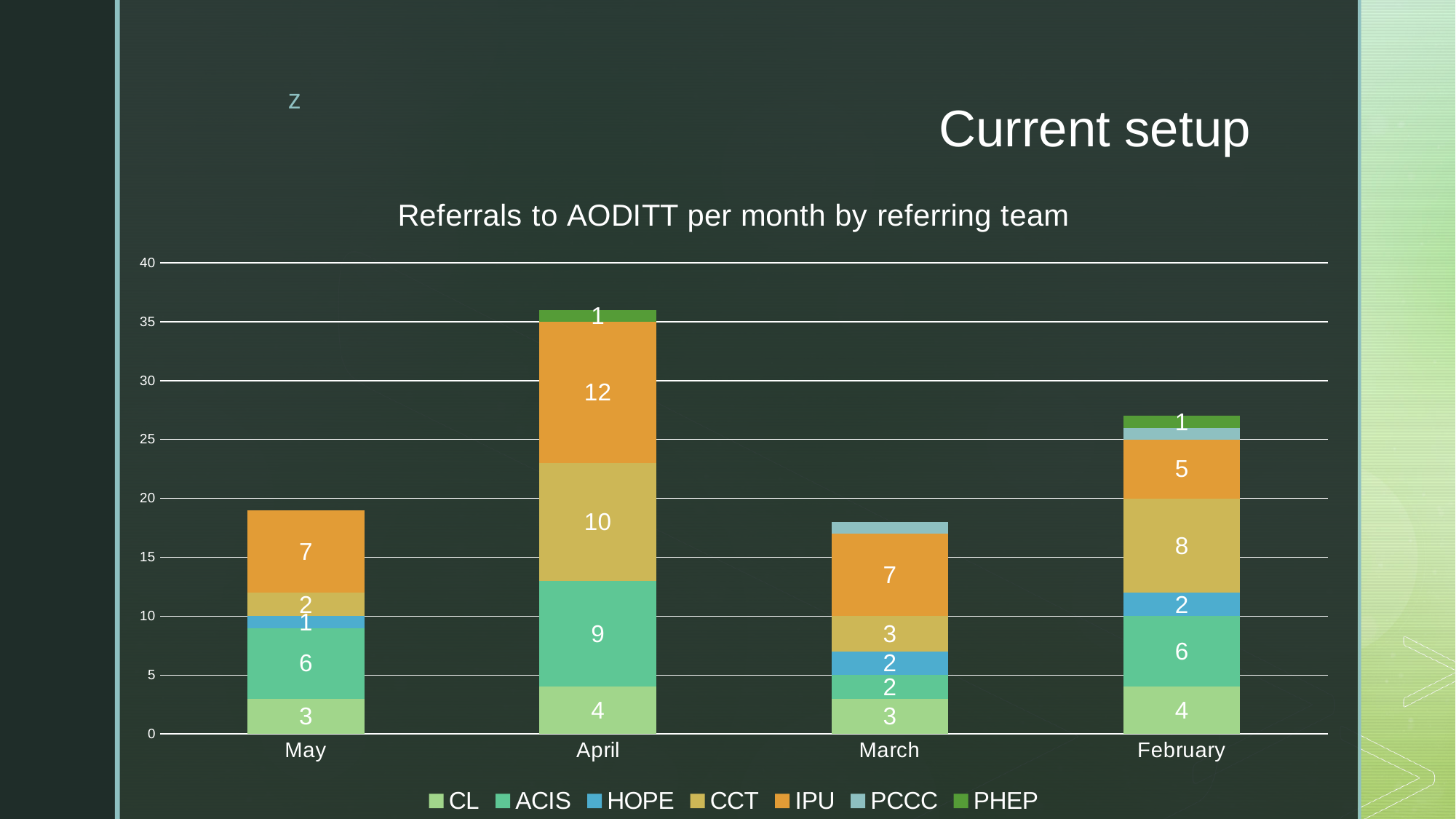
What is the value for CCT in February? 8 Which referring team has the smallest segment in the April bar? PHEP What is the total number of referrals in May? 19 How many referrals did ACIS make in May? 6 What is the total number of referrals in April? 36 How many months are shown on the x axis? 4 Which is larger: CCT referrals in April or CCT referrals in March? April What kind of chart is shown on the slide? Stacked bar chart What is the difference between IPU referrals in April and IPU referrals in February? 7 How many referring teams does the legend list? 7 Which month has the tallest stacked bar? April How many referrals did IPU make in April? 12